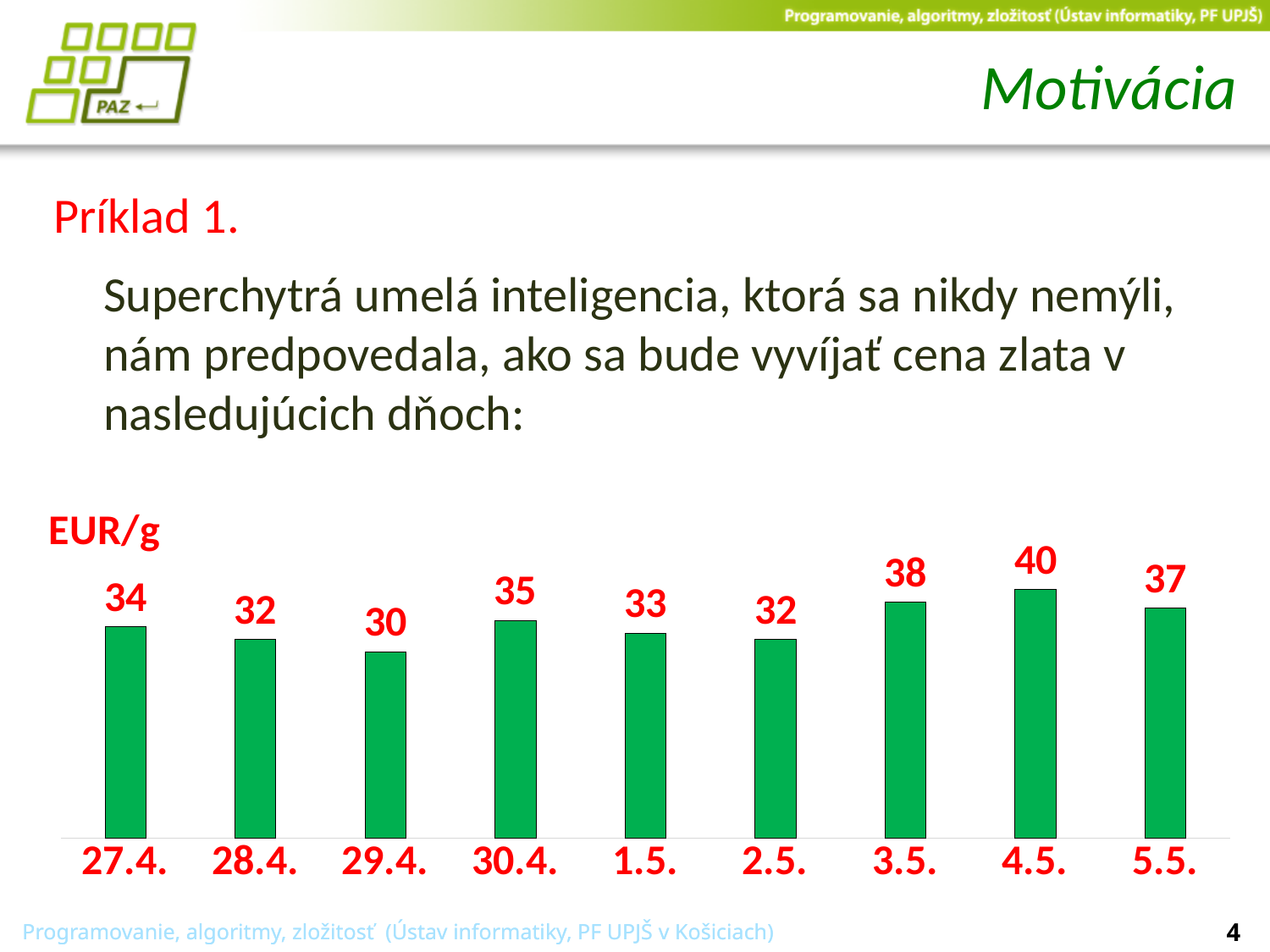
What unit is shown above the chart? EUR/g What kind of chart is shown on the slide? bar chart Which date has the highest value? 4.5. What is the difference between the values for 3.5. and 2.5.? 6 Which date has the lowest value? 29.4. How many dates are shown on the x axis? 9 What is the value for 1.5.? 33 What is the value for 4.5.? 40 Do the values rise or fall from 1.5. to 4.5.? rise What is the difference between the values for 4.5. and 29.4.? 10 Which is larger, the value for 30.4. or the value for 5.5.? 5.5. What is the value for 27.4.? 34